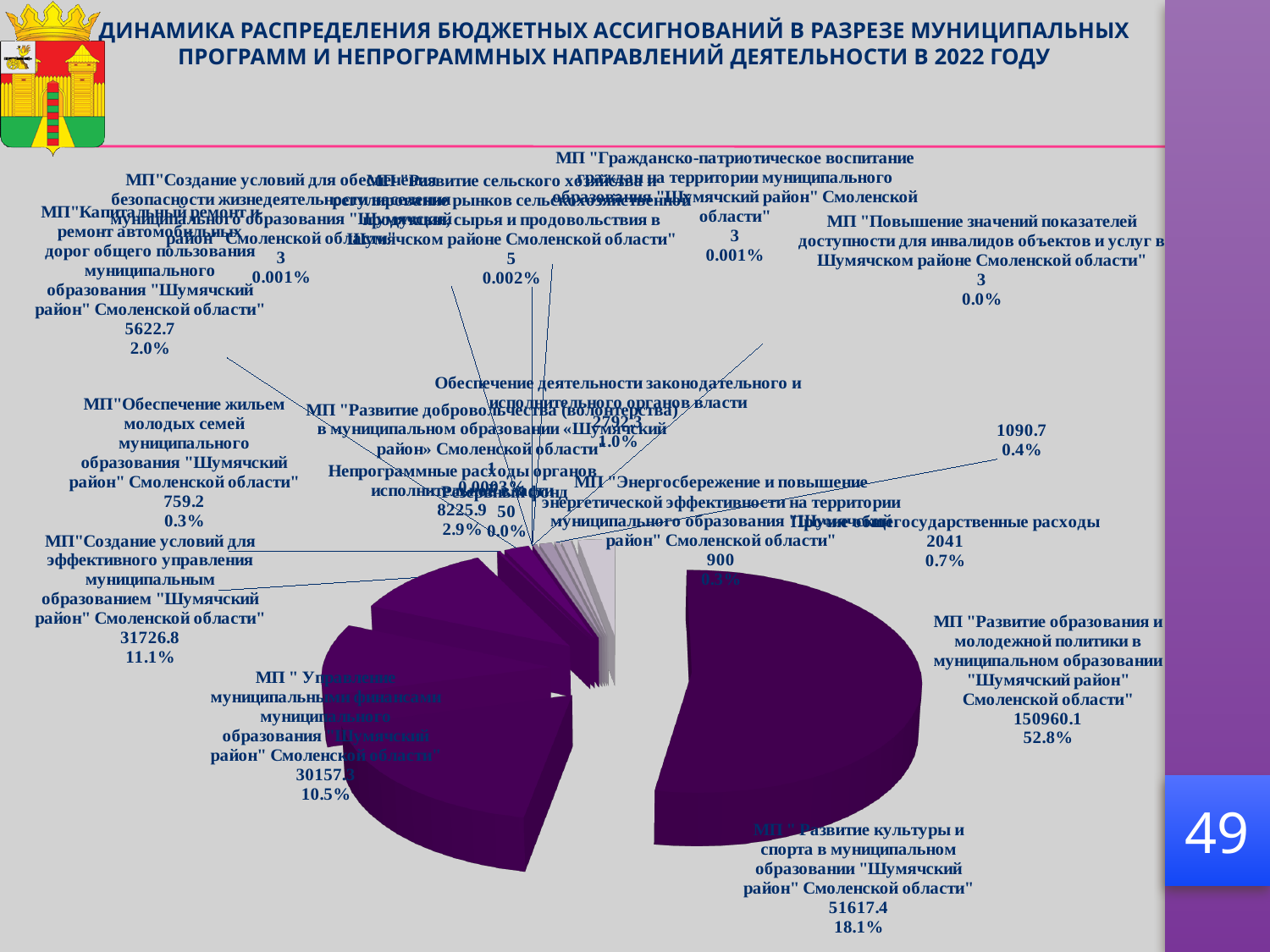
What value is shown for МП "Развитие культуры и спорта в муниципальном образовании "Шумячский район" Смоленской области"? 51617.4 What percentage is shown for МП "Энергосбережение и повышение энергетической эффективности"? 0.3% What share of the pie does МП "Развитие образования и молодежной политики" hold? 52.8% What is the difference between the values for МП "Развитие образования и молодежной политики" (150960.1) and МП "Развитие культуры и спорта" (51617.4)? 99342.7 What percentage is shown for МП "Управление муниципальными финансами"? 10.5% What value is shown for МП "Капитальный ремонт и ремонт автомобильных дорог общего пользования"? 5622.7 Which municipal program has the largest share of the pie? МП "Развитие образования и молодежной политики в муниципальном образовании "Шумячский район" Смоленской области" What kind of chart is shown on the slide? pie chart What value is shown for МП "Создание условий для эффективного управления муниципальным образованием "Шумячский район" Смоленской области"? 31726.8 Which is larger: the value for МП "Обеспечение жильем молодых семей" or the value for Прочие общегосударственные расходы? Прочие общегосударственные расходы What value is shown for Непрограммные расходы органов исполнительной власти? 8225.9